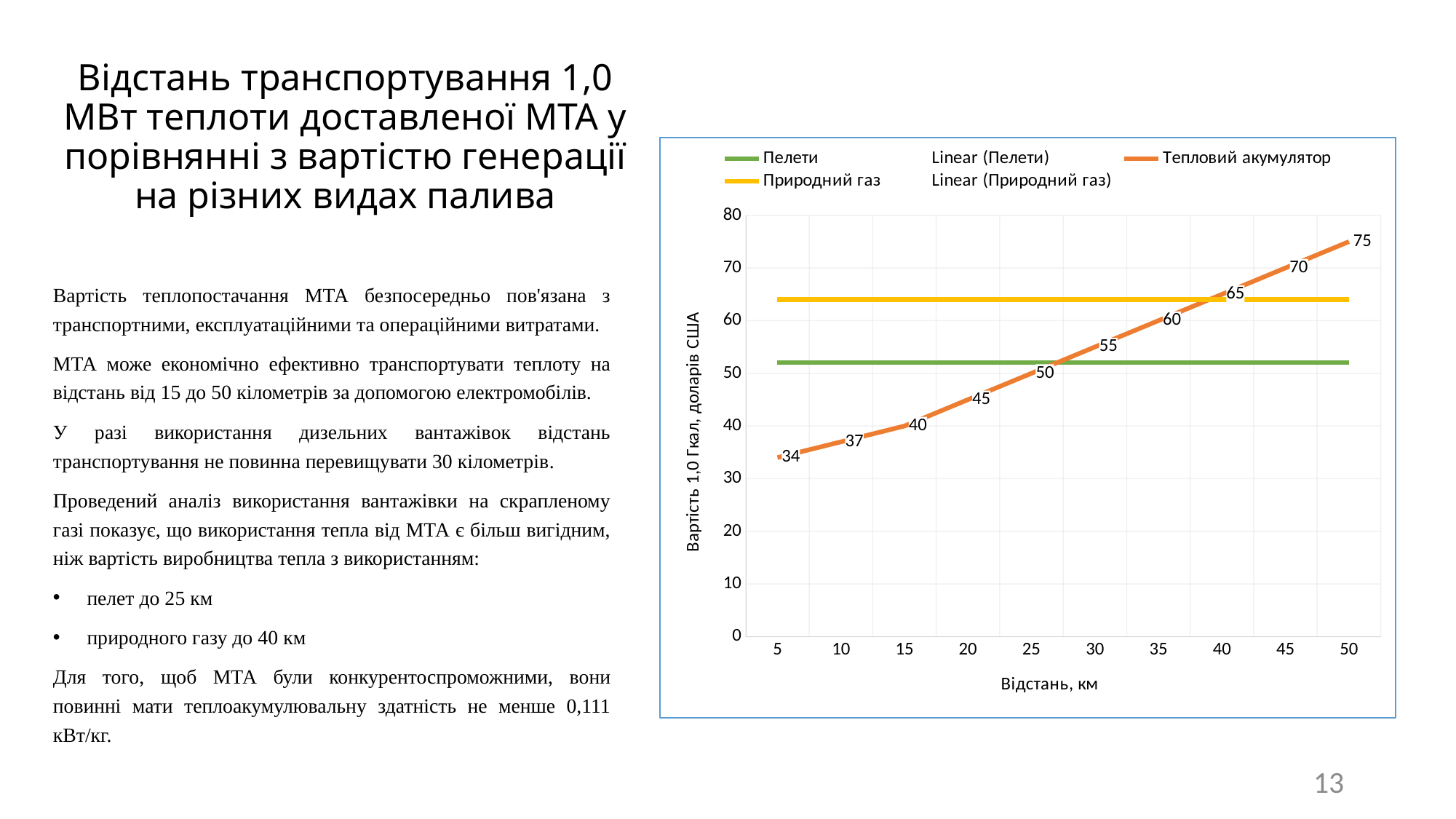
Does the Тепловий акумулятор series rise or fall as distance increases? rises What is the difference between the Тепловий акумулятор values at 50 km and 5 km? 41 At which distance does the Тепловий акумулятор series reach its highest value? 50 Is the value of the Пелети line greater or less than 60? less Is the value of the Природний газ line greater or less than 60? greater What is the value of the Тепловий акумулятор series at a distance of 25 km? 50 How many data points are labelled on the Тепловий акумулятор series? 10 How many entries does the legend list? 5 What is the value of the Тепловий акумулятор series at a distance of 50 km? 75 At which distance does the Тепловий акумулятор series have its lowest value? 5 What is the value of the Тепловий акумулятор series at a distance of 5 km? 34 Which is larger for the Тепловий акумулятор series: the value at 15 km or the value at 35 km? 35 km